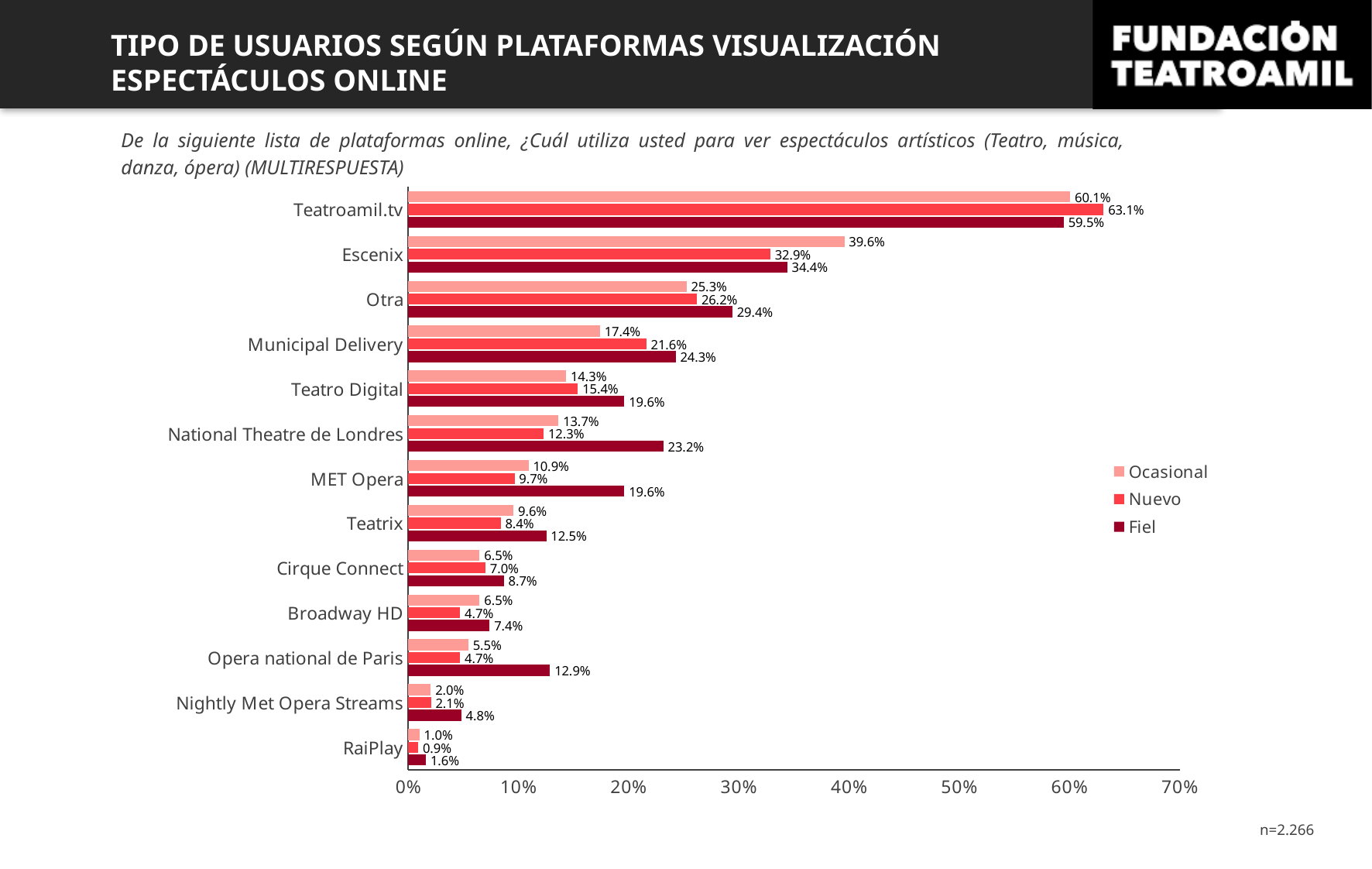
Which is larger for Opera national de Paris: the Fiel value or the Ocasional value? Fiel How many series does the legend list? 3 Which platform has the highest Nuevo value? Teatroamil.tv What is the Nuevo value for Escenix? 32.9% What is the Fiel value for Teatroamil.tv? 59.5% Is the Nuevo value for Teatroamil.tv greater or less than 60%? greater How many platforms are listed on the chart? 13 What is the Ocasional value for Municipal Delivery? 17.4% Which platform has the lowest Fiel value? RaiPlay Which series is shown in the darkest colour in the legend? Fiel What is the difference between the Fiel and Ocasional values for National Theatre de Londres? 9.5% What kind of chart is shown on the slide? Bar chart